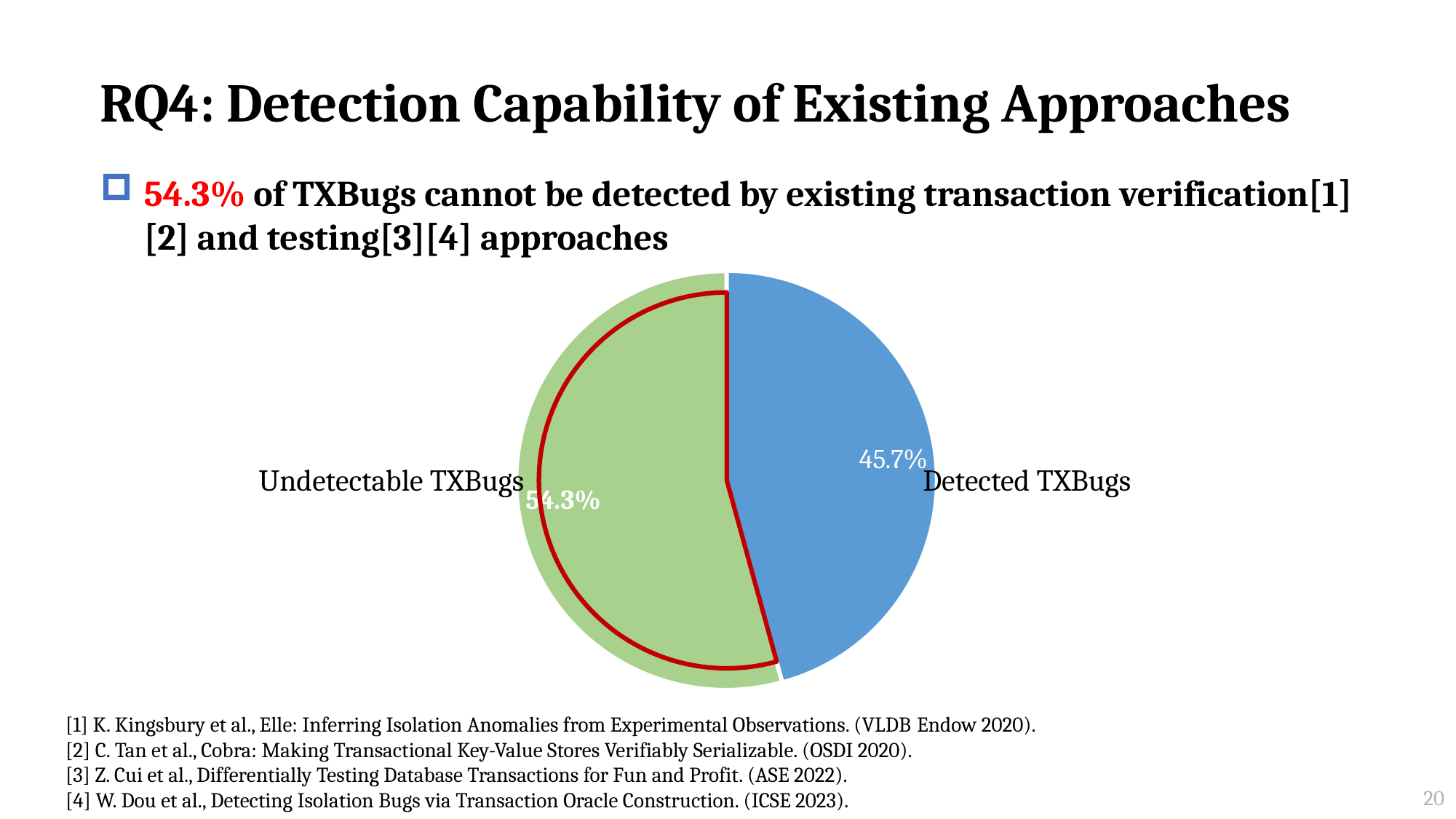
How many slices does the pie chart have? 2 What is the difference in percentage points between the Undetectable TXBugs slice and the Detected TXBugs slice? 8.6 What share of the pie is labelled Detected TXBugs? 45.7% What colour is the Undetectable TXBugs slice? green What share of the pie is labelled Undetectable TXBugs? 54.3% What colour is the Detected TXBugs slice? blue Which slice of the pie is the largest? Undetectable TXBugs Which is larger, the Undetectable TXBugs slice or the Detected TXBugs slice? Undetectable TXBugs What kind of chart is shown on the slide? pie chart Which slice of the pie is the smallest? Detected TXBugs